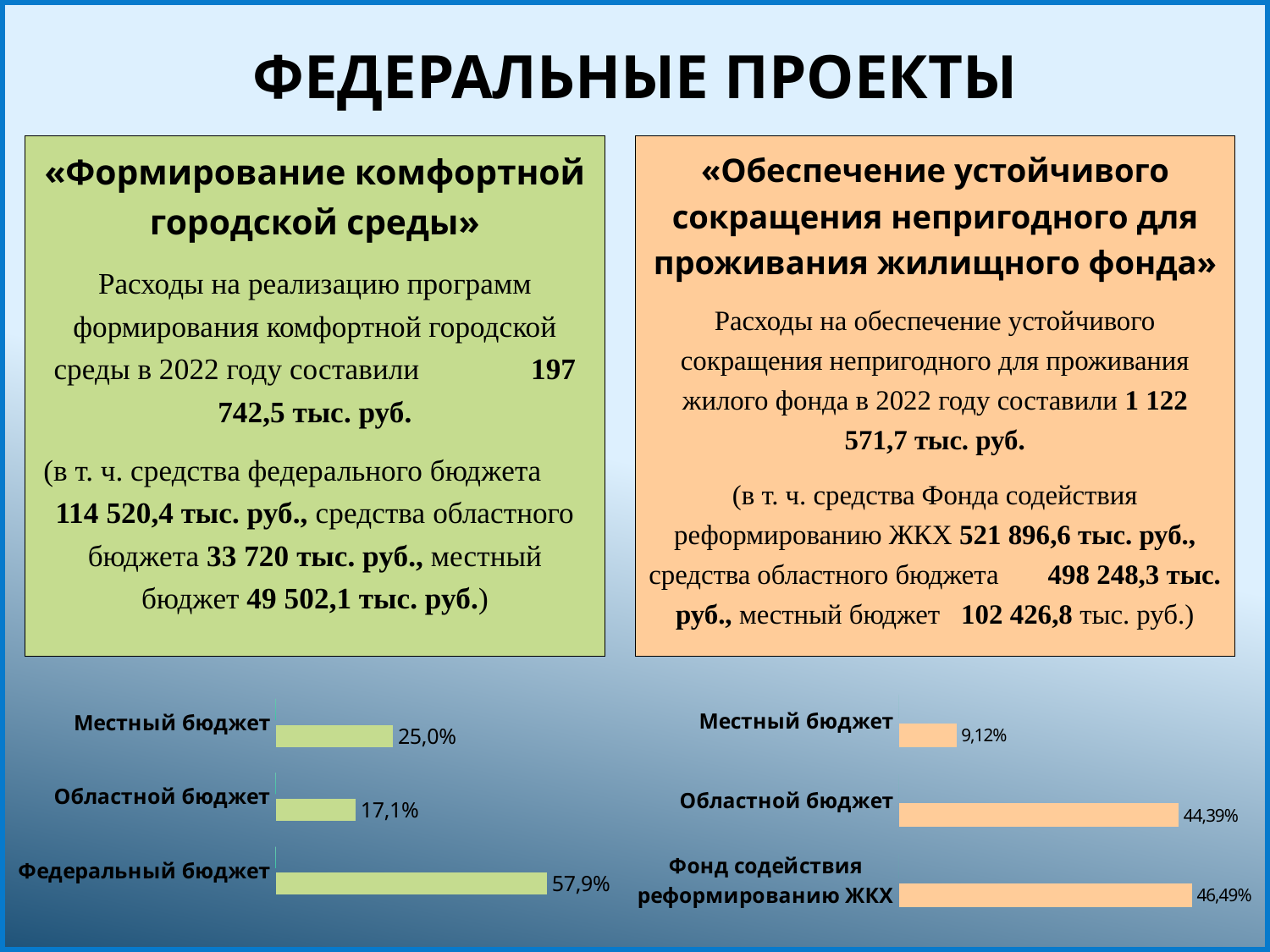
In the right chart, which category has the highest value? Фонд содействия реформированию ЖКХ In the left chart, what is the value for Федеральный бюджет? 57,9% In the left chart, what is the difference between Федеральный бюджет and Местный бюджет? 32,9% In the right chart, which category has the lowest value? Местный бюджет In the right chart, which is larger: Областной бюджет or Фонд содействия реформированию ЖКХ? Фонд содействия реформированию ЖКХ In the right chart, what is the value for Фонд содействия реформированию ЖКХ? 46,49% What type of chart is the left chart? Bar chart In the left chart, which category has the lowest value? Областной бюджет In the right chart, what is the value for Местный бюджет? 9,12% In the left chart, which category has the highest value? Федеральный бюджет In the right chart, what is the difference between Областной бюджет and Местный бюджет? 35,27% In the left chart, what is the value for Областной бюджет? 17,1%